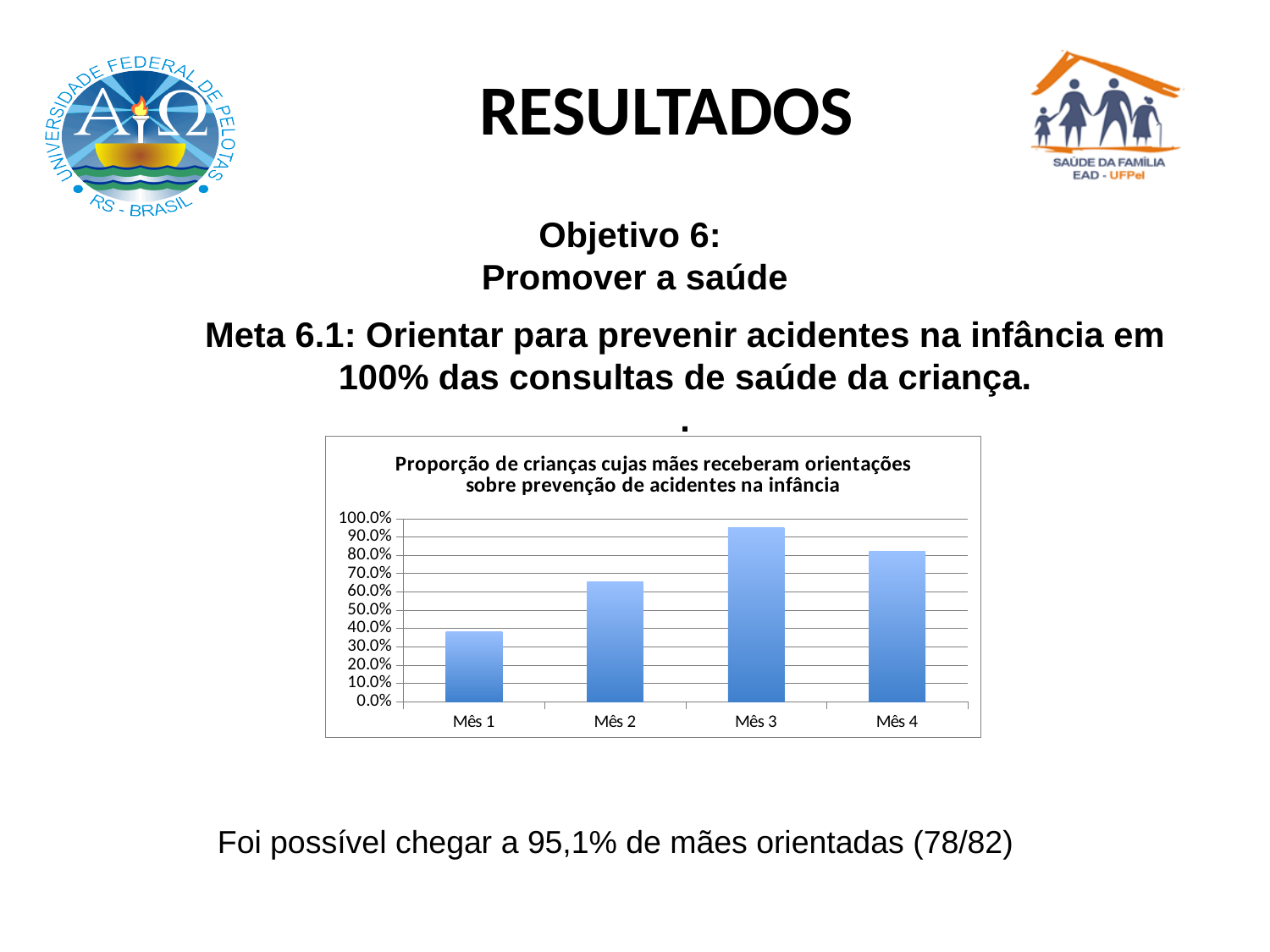
Which month has the highest proportion of children whose mothers received guidance? Mês 3 Is the value for Mês 4 greater or less than 70.0%? greater Which is larger, the value for Mês 2 or the value for Mês 4? Mês 4 How many months (categories) are plotted on the chart? 4 Is the value for Mês 1 greater or less than 50.0%? less What kind of chart is shown on the slide? bar chart Which month has the lowest proportion of children whose mothers received guidance? Mês 1 Which is larger, the value for Mês 1 or the value for Mês 3? Mês 3 Do the values rise or fall from Mês 1 to Mês 3? rise What is the title of the chart? Proporção de crianças cujas mães receberam orientações sobre prevenção de acidentes na infância Is the value for Mês 3 greater or less than 90.0%? greater